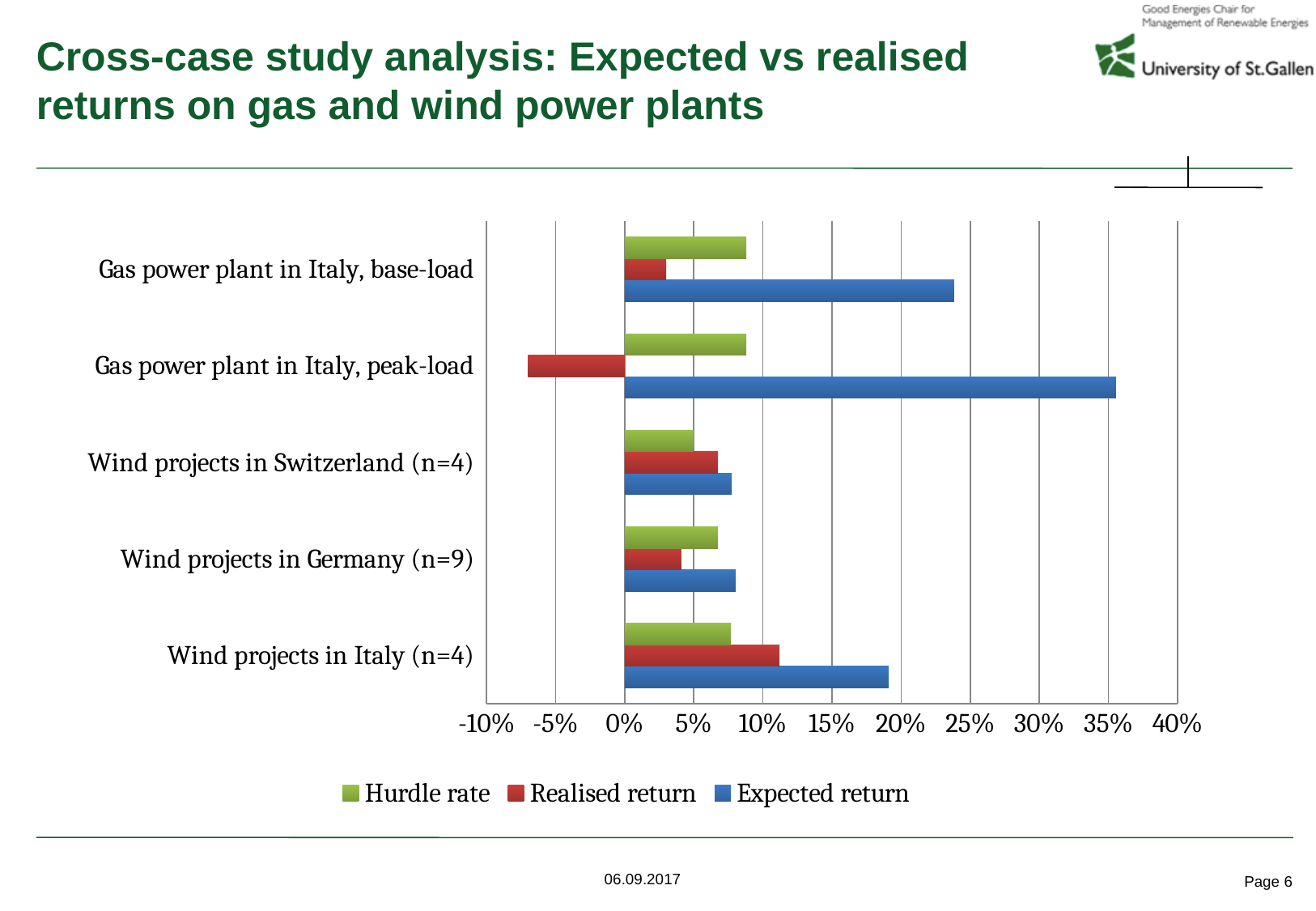
Is the Expected return for Wind projects in Germany (n=9) greater or less than 10%? less How many categories (projects) are shown on the chart? 5 Is the Expected return for Gas power plant in Italy, peak-load greater or less than 30%? greater Is the Realised return for Gas power plant in Italy, peak-load greater or less than 0%? less What kind of chart is shown on the slide? Bar chart Which is larger: the Realised return for Wind projects in Italy (n=4) or for Wind projects in Germany (n=9)? Wind projects in Italy (n=4) How many series does the legend list? 3 Which category has the highest Expected return? Gas power plant in Italy, peak-load What colour represents the Expected return series in the legend? Blue Which category has the lowest Realised return? Gas power plant in Italy, peak-load Which category has the highest Realised return? Wind projects in Italy (n=4)